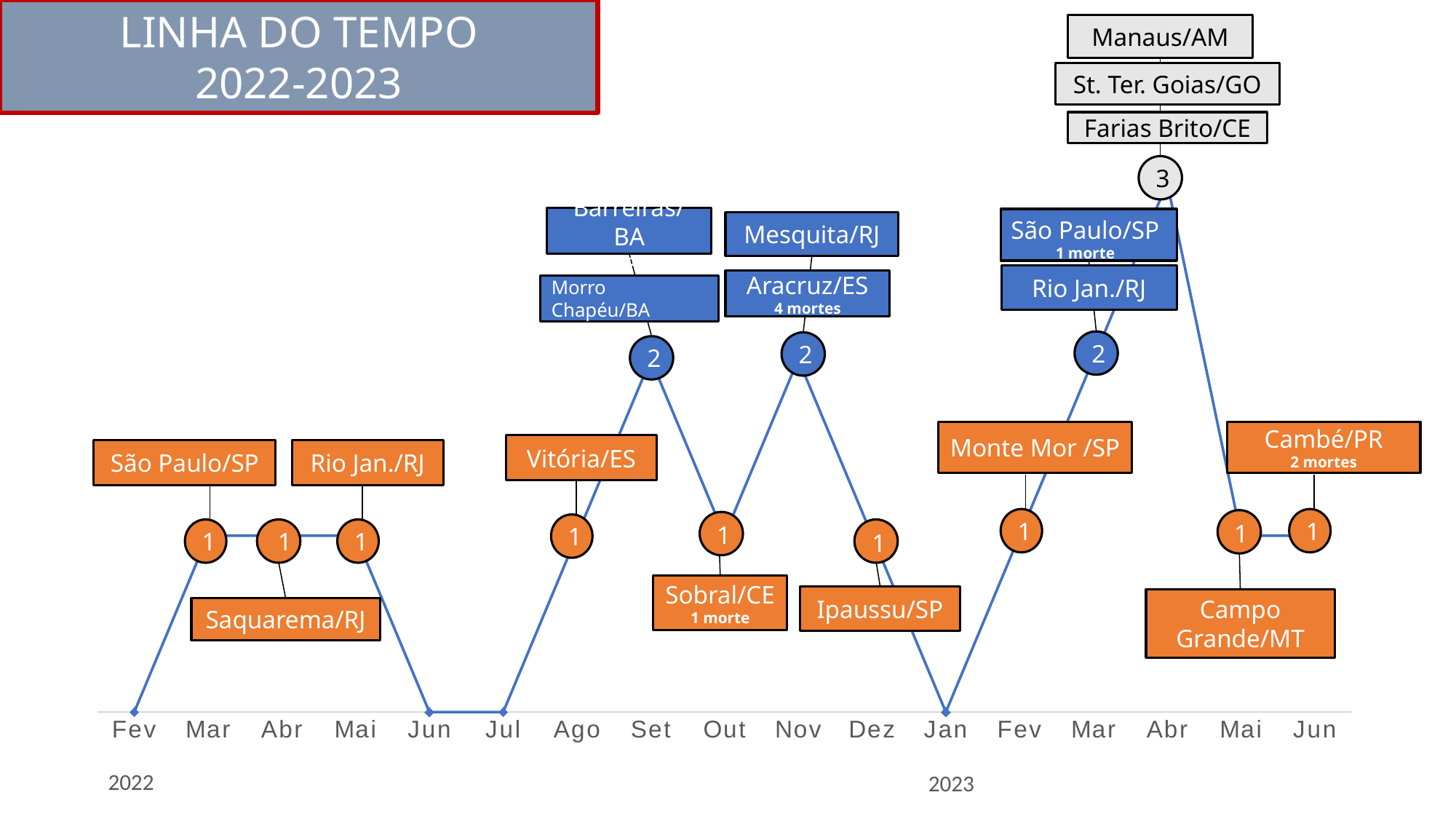
Which is larger, the value for Mar 2023 or the value for Fev 2023? Mar 2023 What is the value plotted for Nov 2022? 2 What is the value plotted for Abr 2023? 3 How many months are shown on the x axis? 17 What is the title of the chart? LINHA DO TEMPO 2022-2023 What is the value plotted for Mar 2022? 1 What is the value plotted for Set 2022? 2 Which city label is attached to the point with value 1 in Ago 2022? Vitória/ES Which month has the highest value on the line? Abr 2023 What kind of chart is shown on the slide? line chart What is the difference between the values for Abr 2023 and Mai 2023? 2 Does the line rise or fall from Jan 2023 to Abr 2023? rise